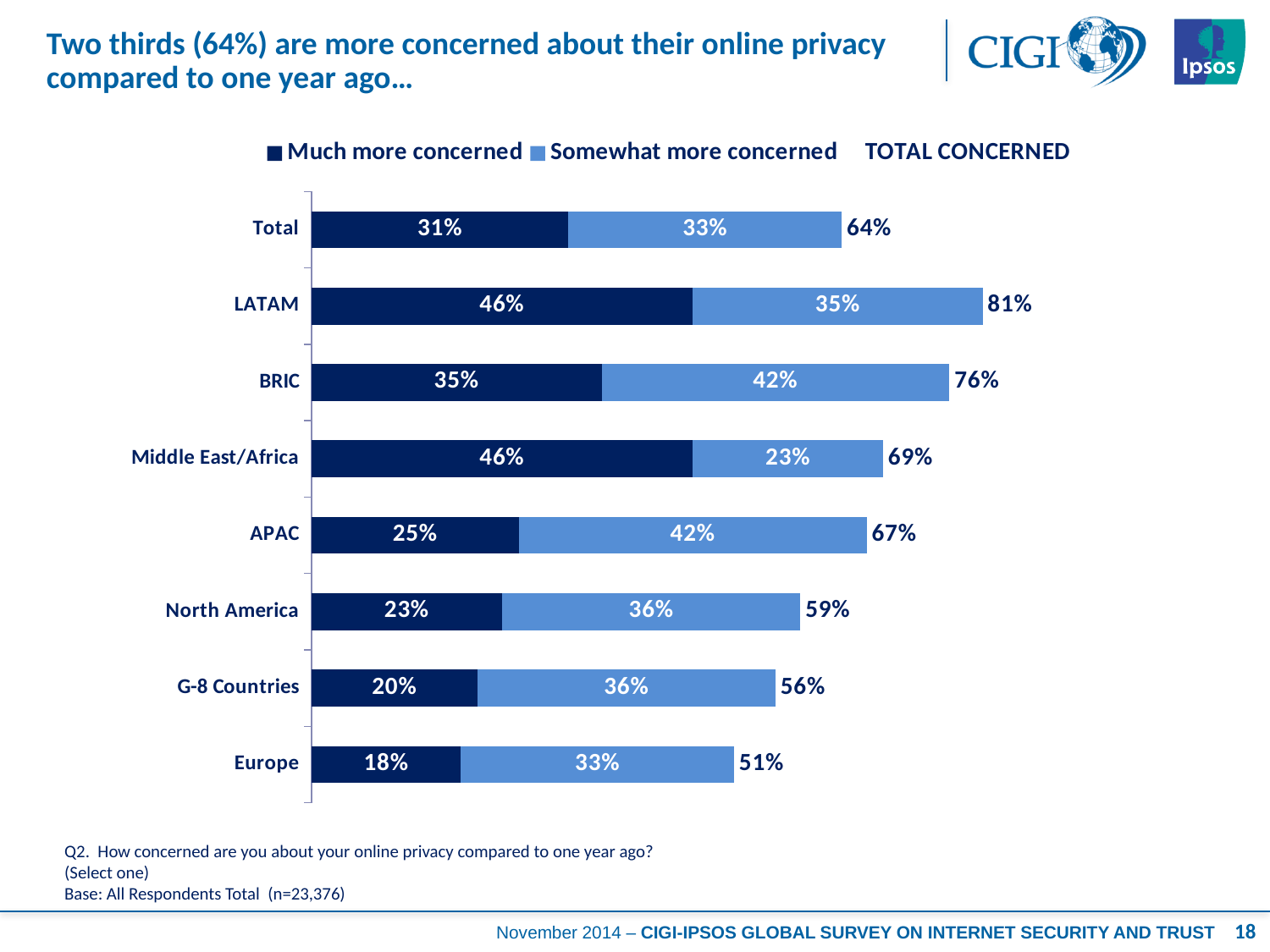
Which region has the lowest 'Much more concerned' value? Europe What is the 'Somewhat more concerned' value for BRIC? 42% How many series does the legend list as stacked bar segments? 2 What kind of chart is shown on the slide? Stacked bar chart Which series is shown in dark blue in the legend? Much more concerned How many categories (bars) are shown in the chart? 8 What is the TOTAL CONCERNED value for North America? 59% What is the total of the stacked bar for G-8 Countries? 56% Which is larger: the 'Somewhat more concerned' value for APAC or for Middle East/Africa? APAC Which region has the highest TOTAL CONCERNED value? LATAM What is the difference between the TOTAL CONCERNED values for LATAM and Europe? 30% What percentage of LATAM respondents are 'Much more concerned'? 46%